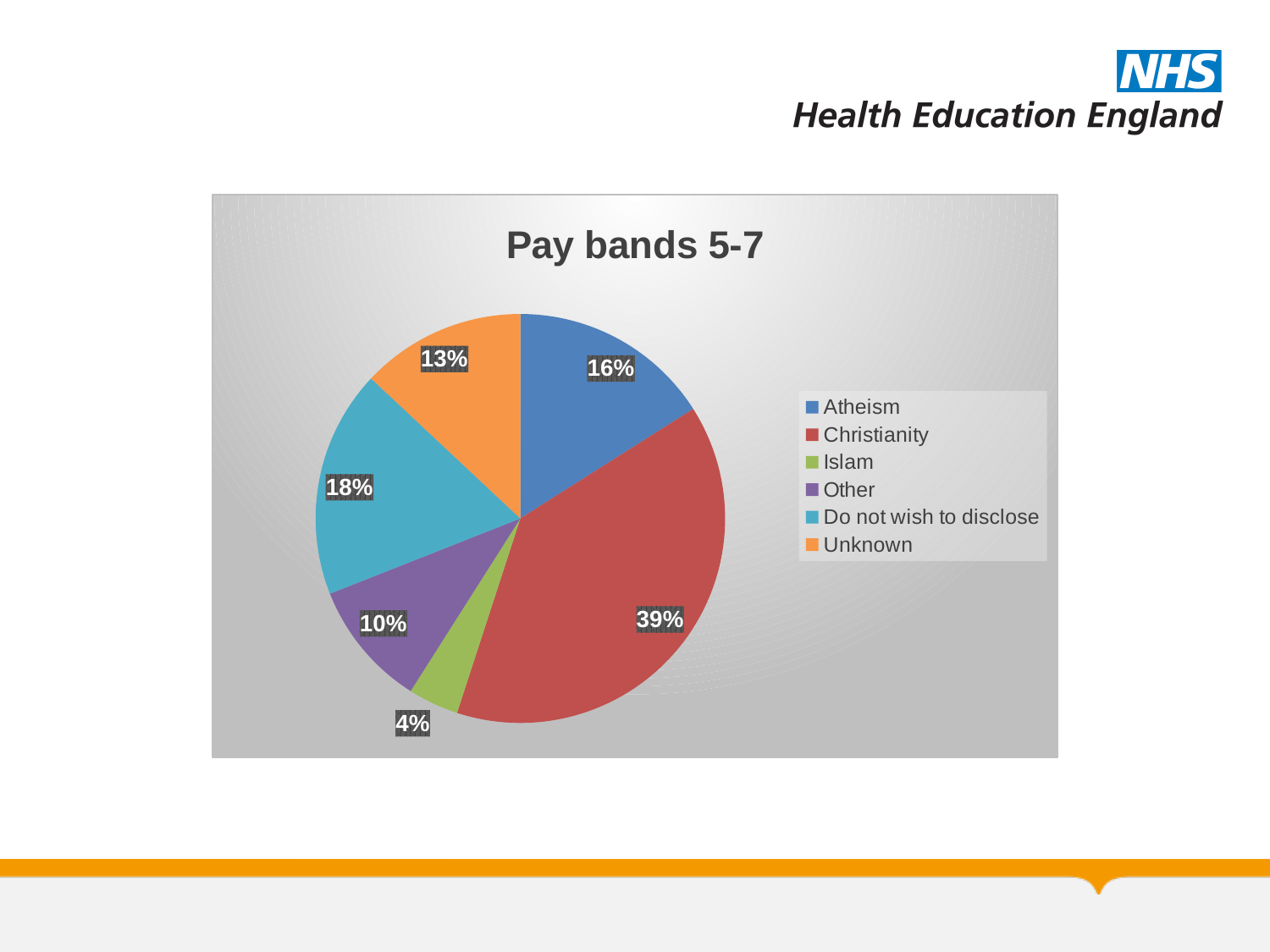
How many categories does the legend list? 6 What type of chart is shown on the slide? pie chart What is the difference in percentage points between Christianity and Atheism? 23 What percentage of the pie is Atheism? 16% What percentage of the pie is Do not wish to disclose? 18% Which category has the smallest share of the pie? Islam Which category has the largest share of the pie? Christianity What percentage of the pie is Unknown? 13% What is the title of the chart? Pay bands 5-7 Which is larger, the share for Other or the share for Unknown? Unknown What percentage of the pie is Christianity? 39% What percentage of the pie is Islam? 4%